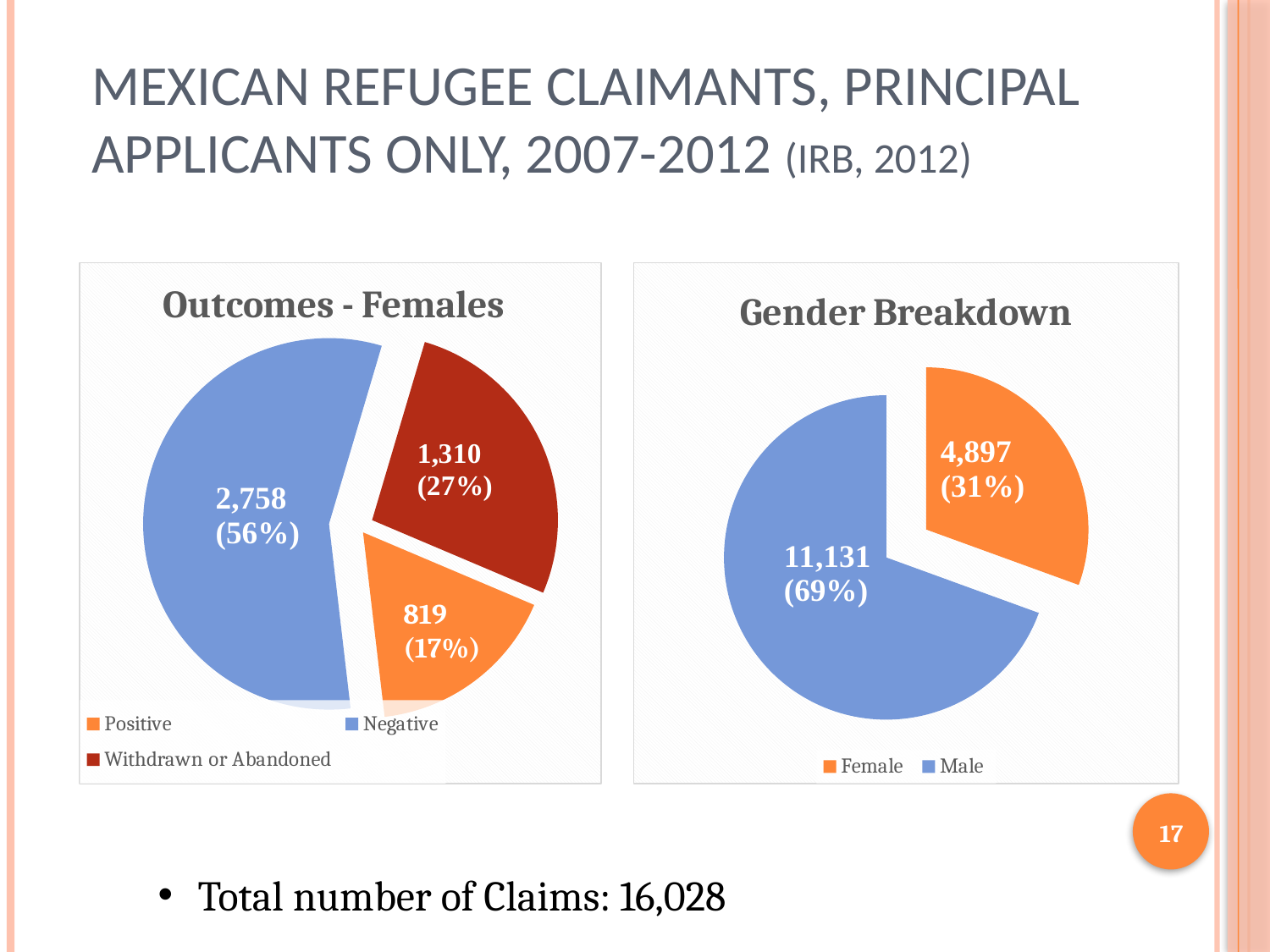
In the 'Outcomes - Females' chart, which category has the largest slice? Negative In the 'Gender Breakdown' chart, what is the value for Male? 11,131 In the 'Outcomes - Females' chart, what is the value for Positive? 819 In the 'Outcomes - Females' chart, what share of the pie is Withdrawn or Abandoned? 27% What kind of chart is the 'Gender Breakdown' chart? Pie chart In the 'Gender Breakdown' chart, what share of the pie is Female? 31% In the 'Outcomes - Females' chart, what is the difference between the Negative and Positive values? 1,939 In the 'Gender Breakdown' chart, what is the difference between the Male and Female values? 6,234 In the 'Gender Breakdown' chart, which is larger, Female or Male? Male In the 'Outcomes - Females' chart, which category has the smallest slice? Positive In the 'Outcomes - Females' chart, what is the value for Withdrawn or Abandoned? 1,310 In the 'Outcomes - Females' chart, what is the value for Negative? 2,758